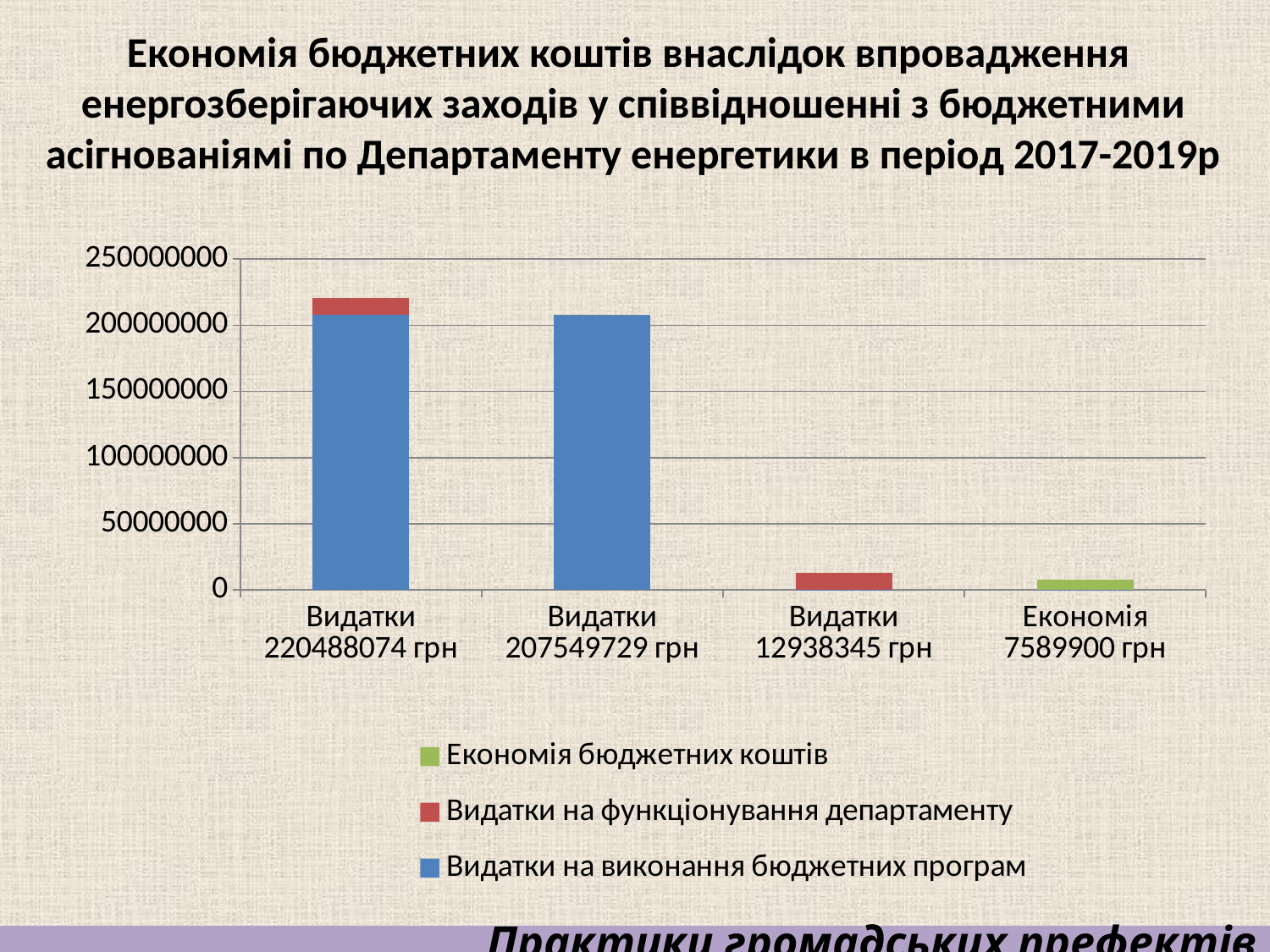
Which category has the tallest bar? Видатки 220488074 грн Is the value of the second bar (Видатки 207549729 грн) greater or less than 200000000? greater How many series does the chart's legend list? 3 What value is printed for the third category (the red bar)? 12938345 грн What is the difference between the third category value (12938345 грн) and the "Економія" value (7589900 грн)? 5348445 грн How many categories are shown along the x axis of the chart? 4 Which category has the shortest bar? Економія 7589900 грн Which is larger: the third category (Видатки 12938345 грн) or the fourth category (Економія 7589900 грн)? Видатки 12938345 грн Which colour represents "Економія бюджетних коштів" in the legend? Green What kind of chart is shown on the slide? Stacked bar chart What value is printed for the category "Економія"? 7589900 грн What is the difference between the first category value (220488074 грн) and the second category value (207549729 грн)? 12938345 грн